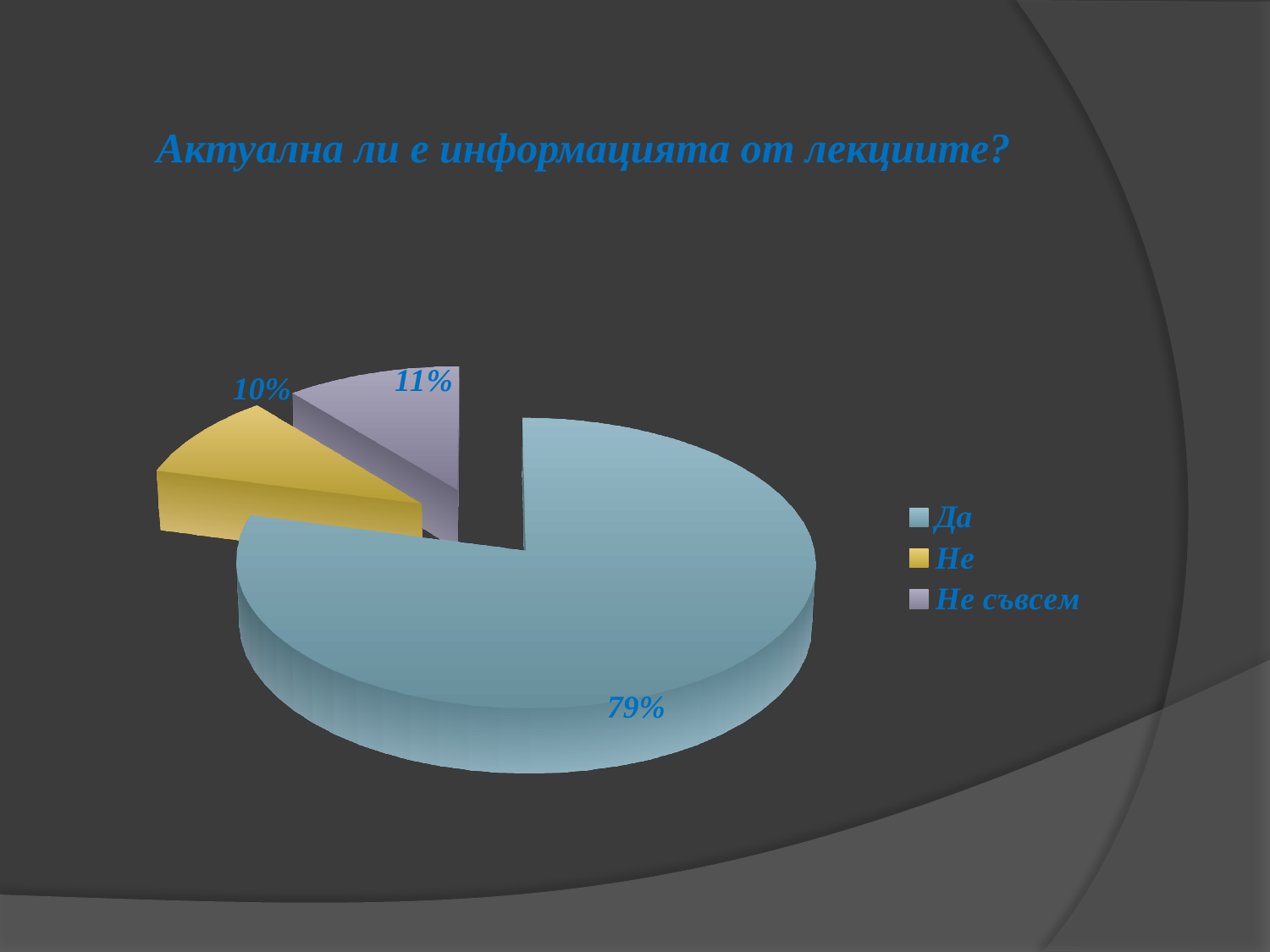
What share of the pie does "Не съвсем" represent? 11% Which category has the largest slice of the pie? Да Which category has the smallest slice of the pie? Не Which is larger, the share for "Да" or the share for "Не"? Да What is the difference in percentage points between "Не съвсем" and "Не"? 1 What is the title of the chart? Актуална ли е информацията от лекциите? How many categories does the pie chart show? 3 What is the difference in percentage points between "Да" and "Не съвсем"? 68 What kind of chart is shown on the slide? Pie chart What share of the pie does "Не" represent? 10% Which colour represents "Не" in the legend? Yellow What share of the pie does "Да" represent? 79%